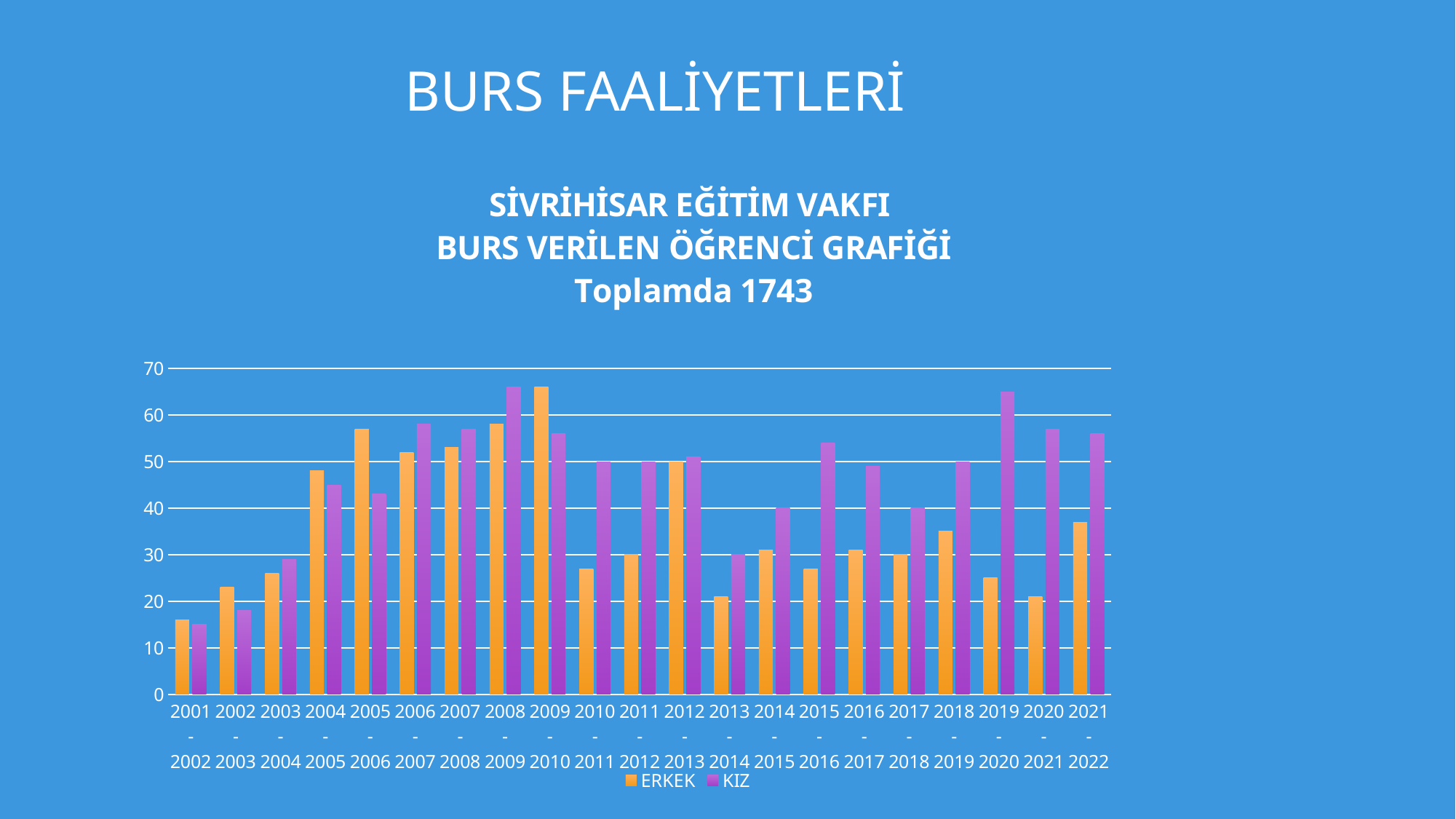
What kind of chart is shown on the slide? bar chart In which academic year is the ERKEK value lowest? 2001-2002 How many series does the legend list? 2 Is the KIZ value for 2019-2020 greater or less than 60? greater For 2005-2006, which series has the larger value, ERKEK or KIZ? ERKEK How many academic-year categories are shown on the x axis? 21 Is the ERKEK value for 2010-2011 greater or less than 30? less For 2019-2020, which series has the larger value, ERKEK or KIZ? KIZ In which academic year is the KIZ value lowest? 2001-2002 Is the ERKEK value for 2005-2006 greater or less than 50? greater What total number of students is stated in the chart title? 1743 In which academic year is the ERKEK value highest? 2009-2010